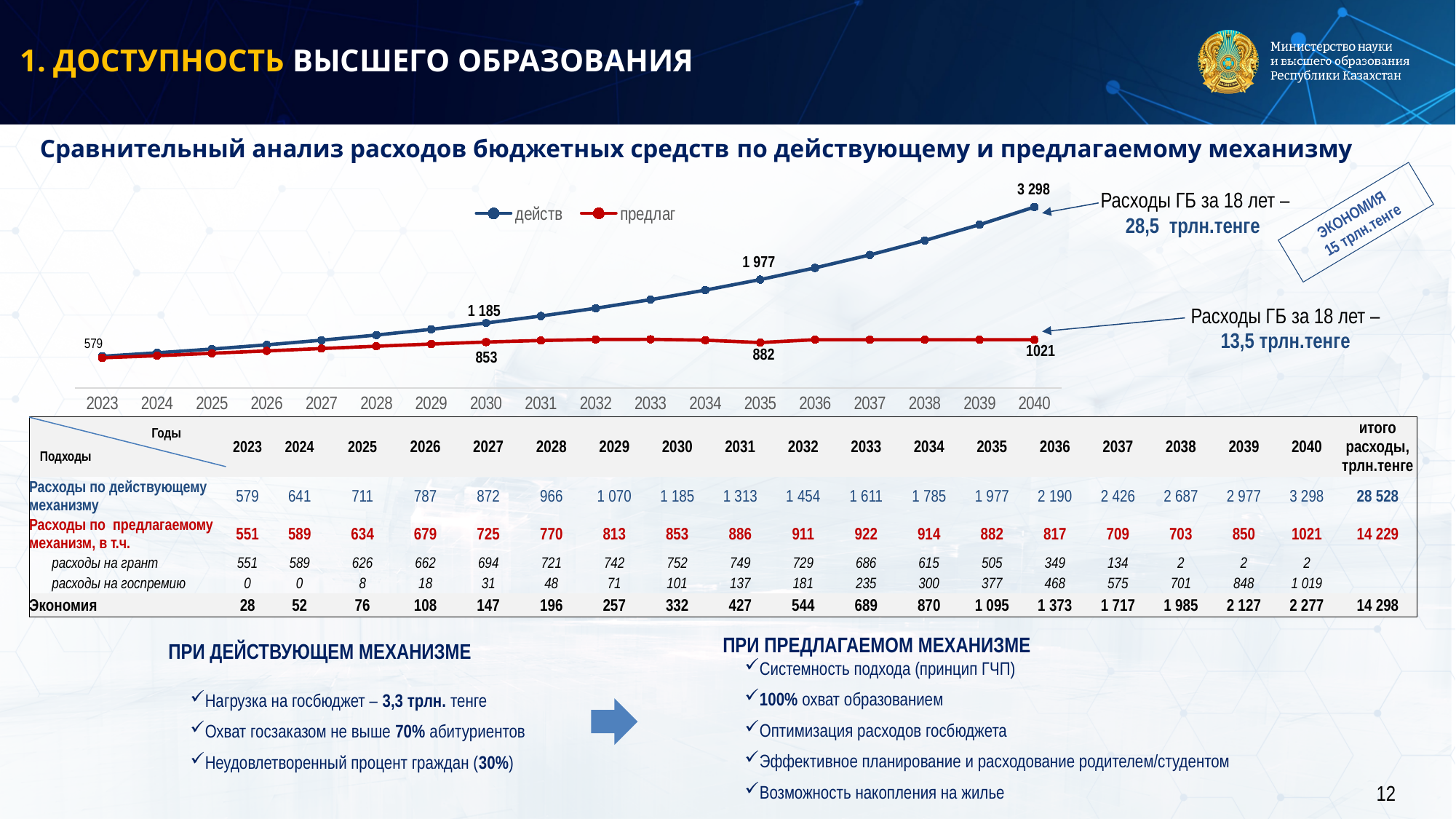
What is the value of the предлаг series in 2030 according to the data label? 853 In which year does the действ series reach its highest value? 2040 What is the value of the предлаг series in 2040 according to the data label? 1021 What kind of chart is shown on the slide? line chart What are the two series named in the chart legend? действ and предлаг What is the value of the действ series in 2035 according to the data label? 1 977 Which series has the higher value in 2040, действ or предлаг? действ What is the value of the действ series in 2040 according to the data label? 3 298 What is the difference between the действ and предлаг values in 2035? 1 095 How many series does the chart legend list? 2 Does the действ series rise or fall from 2023 to 2040? rise How many years are shown on the x axis of the chart? 18